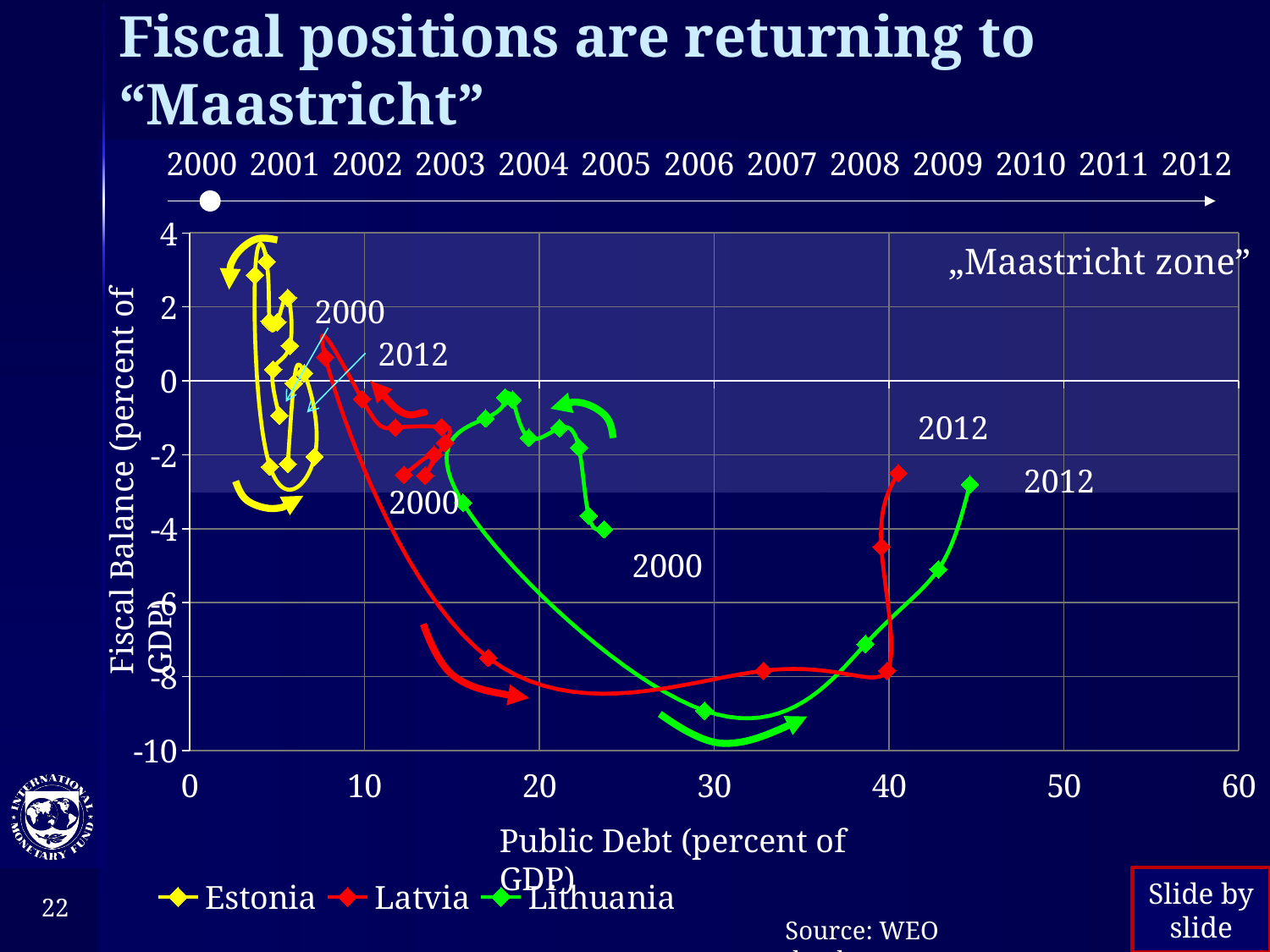
Which country has the larger public debt in 2012, Latvia or Lithuania? Lithuania Is Latvia's lowest fiscal balance greater or less than -6? less How many years are shown on the timeline above the chart? 13 Is Estonia's highest fiscal balance greater or less than 2? greater What is the label of the horizontal axis? Public Debt (percent of GDP) Is Estonia's public debt in 2012 greater or less than 10? less Which country has the highest public debt in 2012? Lithuania Which countries are listed in the legend? Estonia, Latvia, Lithuania How many series does the legend list? 3 Which country has the lowest public debt across the whole period shown? Estonia